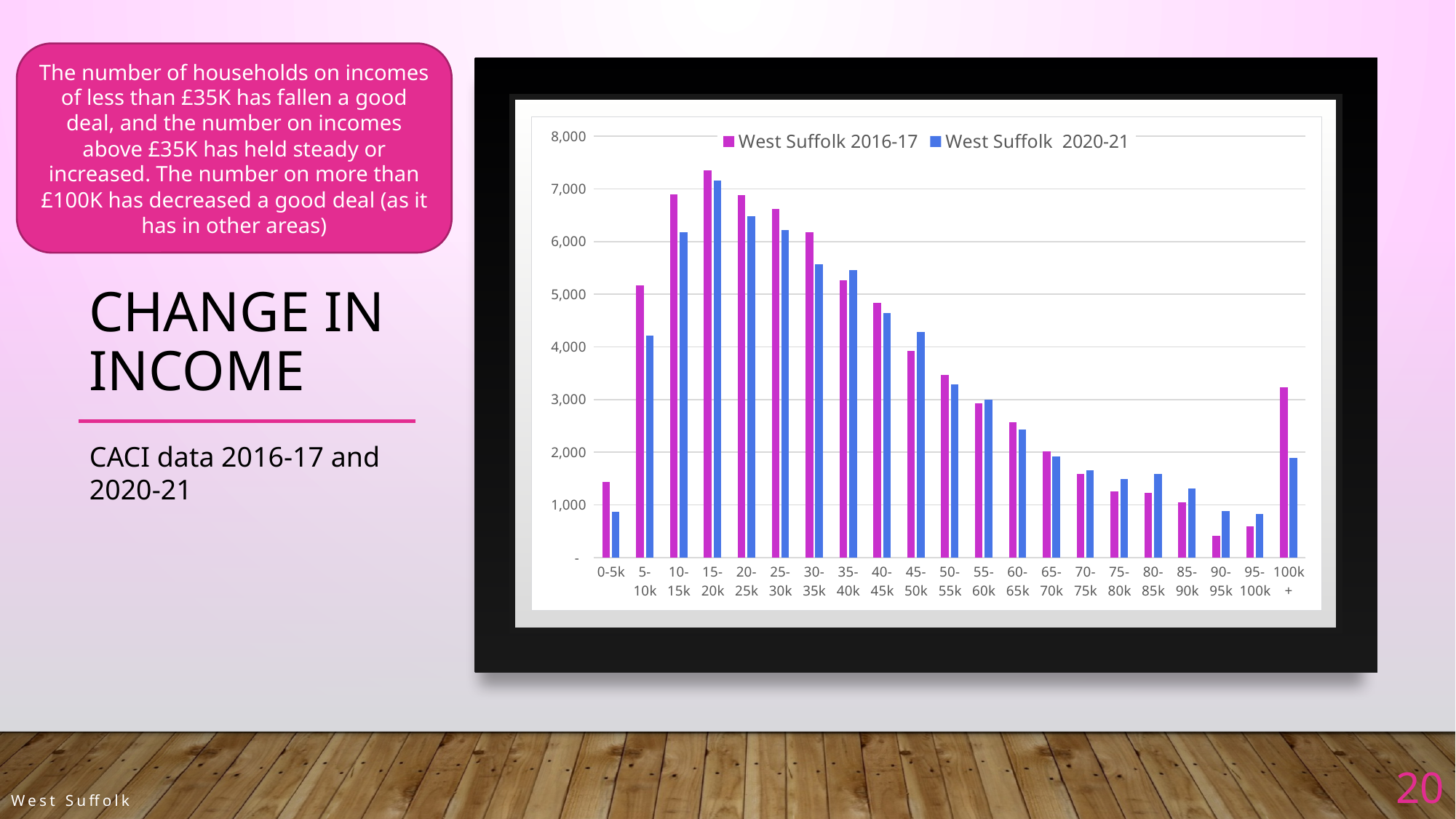
Which income category has the highest value for West Suffolk 2016-17? 15-20k How many series does the legend list? 2 How many income categories are shown on the x axis? 21 In the 5-10k category, which series has the larger value, West Suffolk 2016-17 or West Suffolk 2020-21? West Suffolk 2016-17 In the 45-50k category, which series has the larger value, West Suffolk 2016-17 or West Suffolk 2020-21? West Suffolk 2020-21 Which colour represents the West Suffolk 2020-21 series? blue Is the value for West Suffolk 2016-17 in the 100k+ category greater or less than 3,000? greater Which income category has the lowest value for West Suffolk 2016-17? 90-95k What kind of chart is shown on the slide? bar chart Is the value for West Suffolk 2020-21 in the 5-10k category greater or less than 4,000? greater Which income category has the highest value for West Suffolk 2020-21? 15-20k Is the value for West Suffolk 2020-21 in the 100k+ category greater or less than 2,000? less